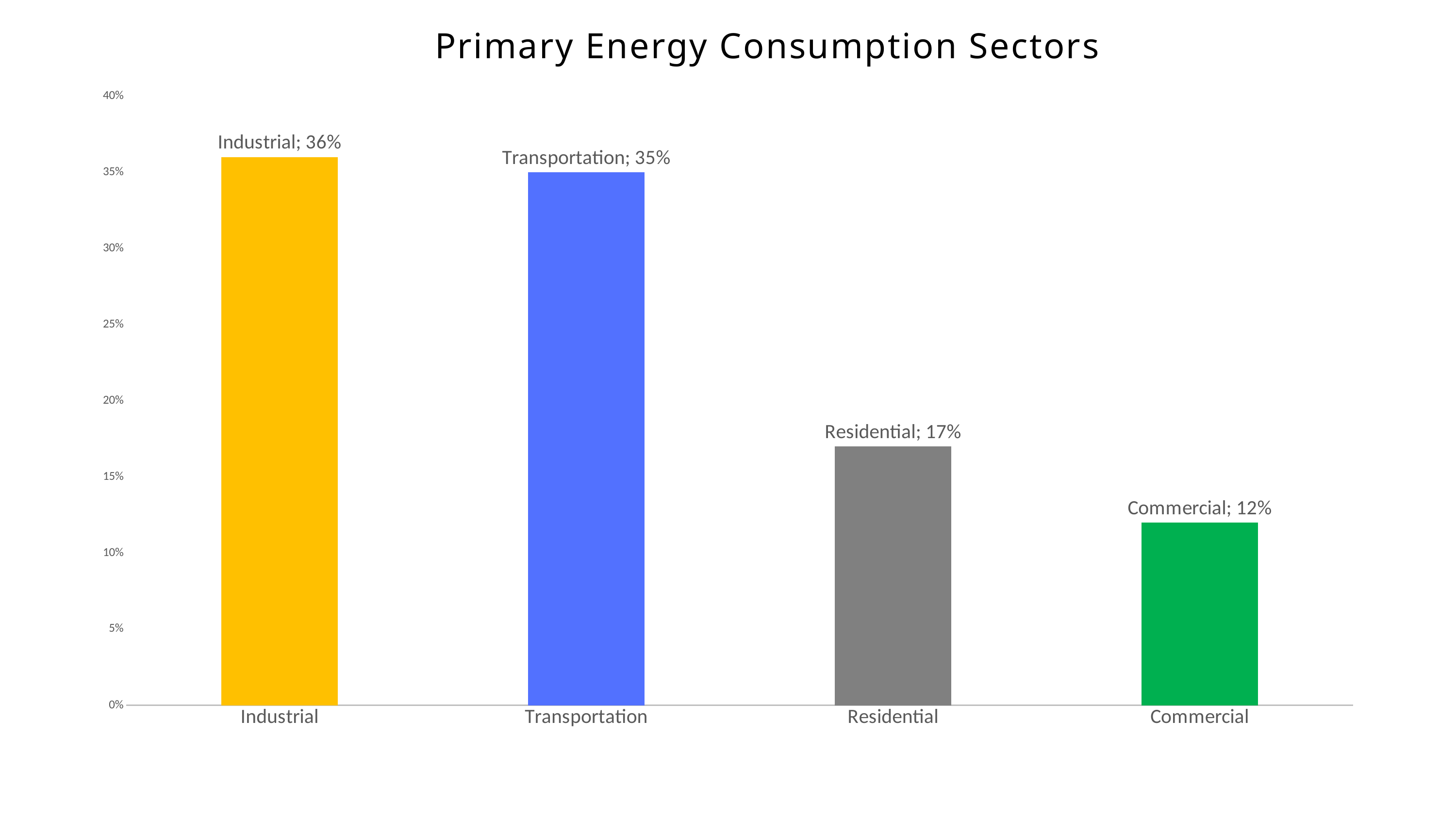
What kind of chart is shown on the slide? Bar chart Which sector has the lowest value? Commercial What is the difference between the Industrial and Commercial values? 24% What is the title of the chart? Primary Energy Consumption Sectors What is the value for Transportation? 35% What is the value for Commercial? 12% What is the value for Industrial? 36% Which sector has the highest value? Industrial What is the difference between the Residential and Commercial values? 5% Which is larger, the value for Residential or the value for Commercial? Residential What is the value for Residential? 17% How many sectors are shown in the chart? 4